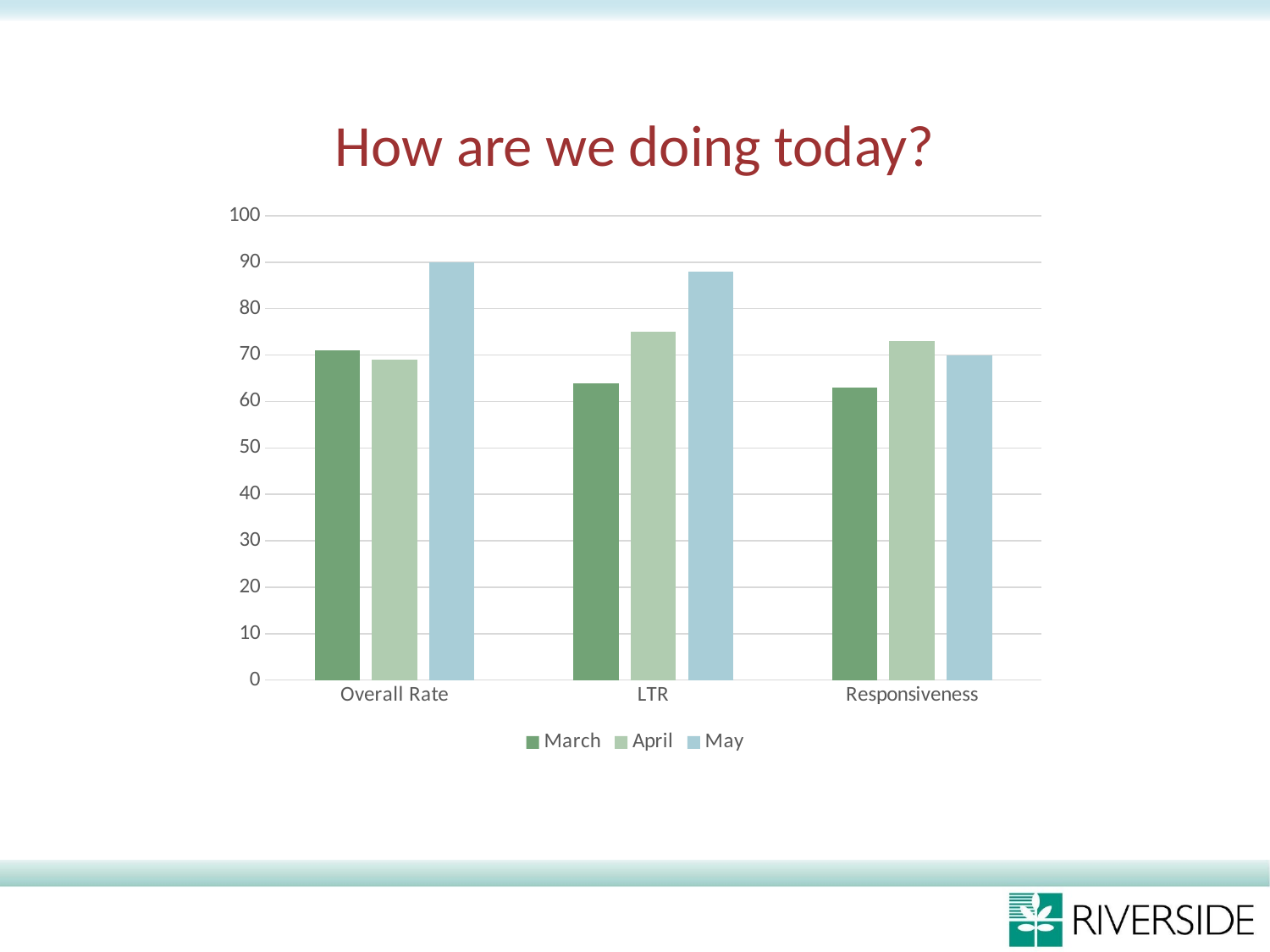
What is the value for May in the Overall Rate category? 90 What is the title of the chart? How are we doing today? What kind of chart is shown on the slide? bar chart Is the value for March in the LTR category greater or less than 70? less Which month has the highest value in the Overall Rate category? May How many series does the legend list? 3 Which is larger: the March value for Overall Rate or the March value for LTR? Overall Rate How many categories are shown on the x axis? 3 Which month has the highest value in the LTR category? May Which month has the lowest value in the Responsiveness category? March What is the value for May in the Responsiveness category? 70 Is the value for May in the LTR category greater or less than 80? greater